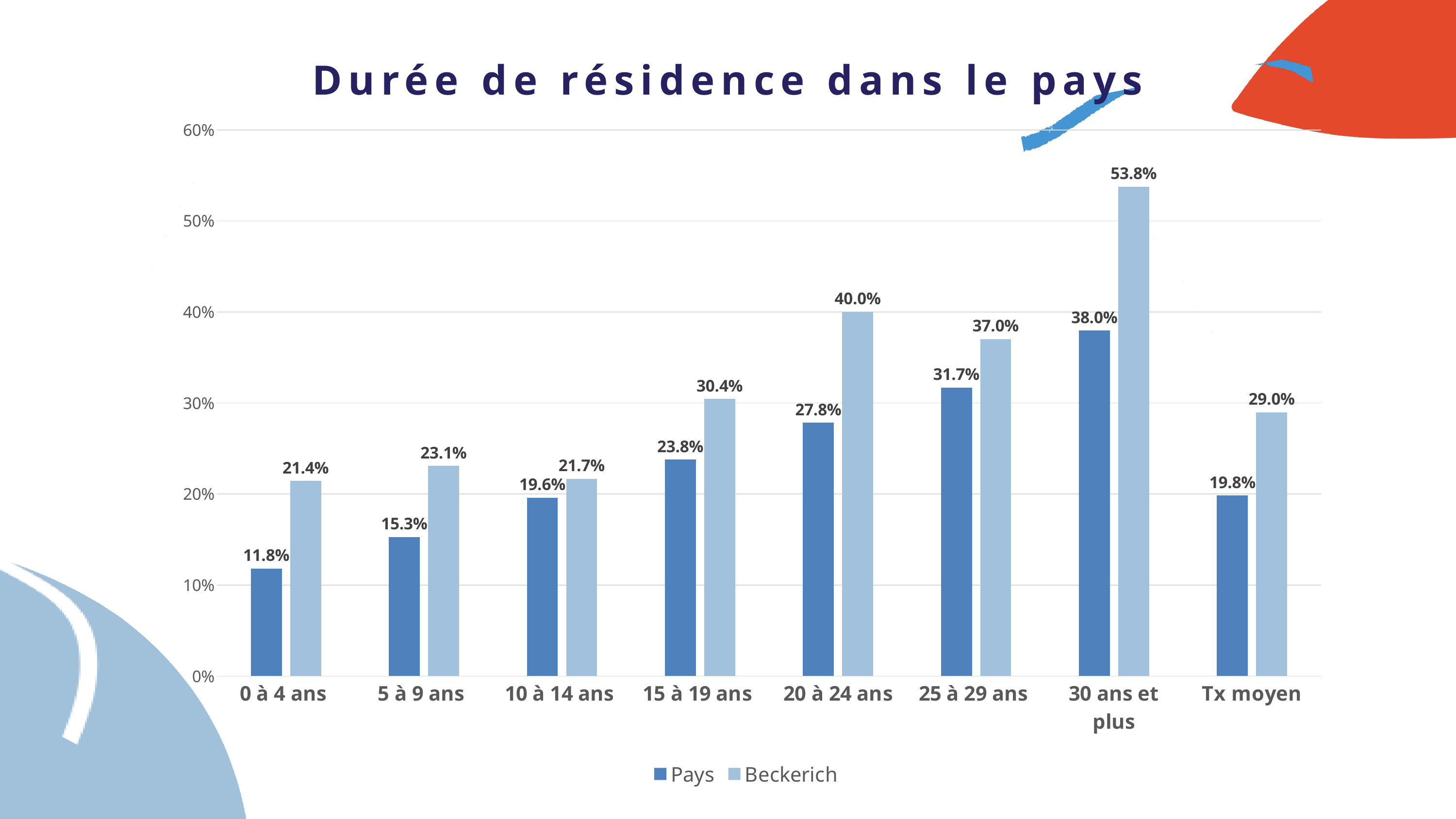
What is the Beckerich value for the '30 ans et plus' category? 53.8% How many series does the legend list? 2 What is the Pays value for 'Tx moyen'? 19.8% Which category has the lowest Pays value? 0 à 4 ans What kind of chart is shown on the slide? Bar chart What is the Pays value for the '0 à 4 ans' category? 11.8% How many categories are shown on the x axis? 8 What is the title of the chart? Durée de résidence dans le pays Which category has the highest Beckerich value? 30 ans et plus Which is larger for '25 à 29 ans', the Pays value or the Beckerich value? Beckerich What is the difference between the Beckerich and Pays values for '20 à 24 ans'? 12.2% Do the Beckerich values rise or fall from '0 à 4 ans' to '30 ans et plus'? Rise